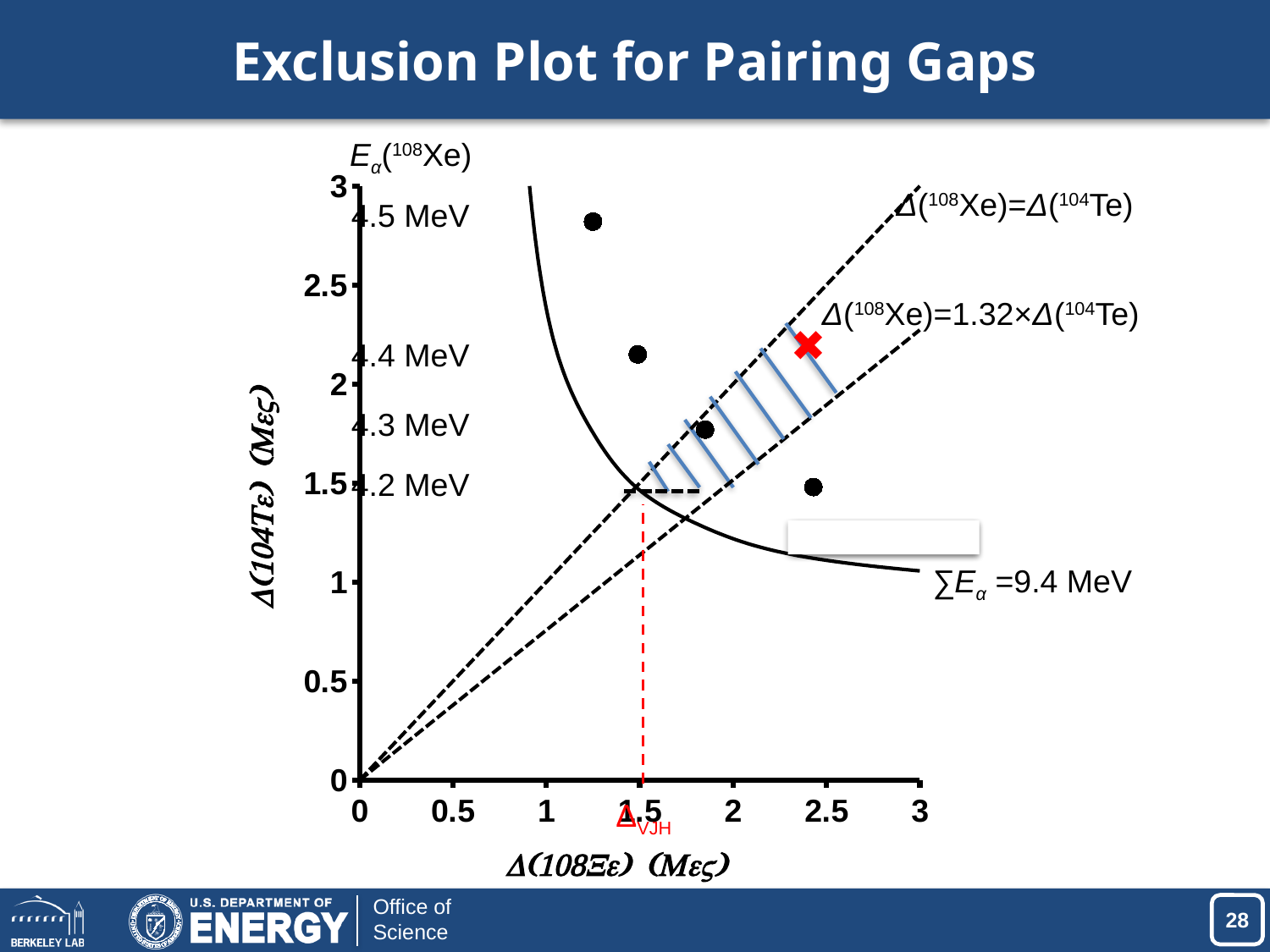
What kind of chart is shown on the slide? scatter plot What is the title of the slide's chart? Exclusion Plot for Pairing Gaps What multiplication factor appears in the label of the lower dashed line, Δ(108Xe)=?×Δ(104Te)? 1.32 Is the x value of the red X marker greater or less than 2? greater Which black dot has the highest y value: the leftmost one or the rightmost one? the leftmost one Is the y value of the rightmost black dot greater or less than 2? less Is the y value of the leftmost black dot greater or less than 2.5? greater What is the highest value shown on the x axis? 3 What value of ∑Eα is labelled on the solid curve? 9.4 MeV How many black dots are plotted on the chart? 4 At what x-axis value is the red dashed vertical line drawn? 1.5